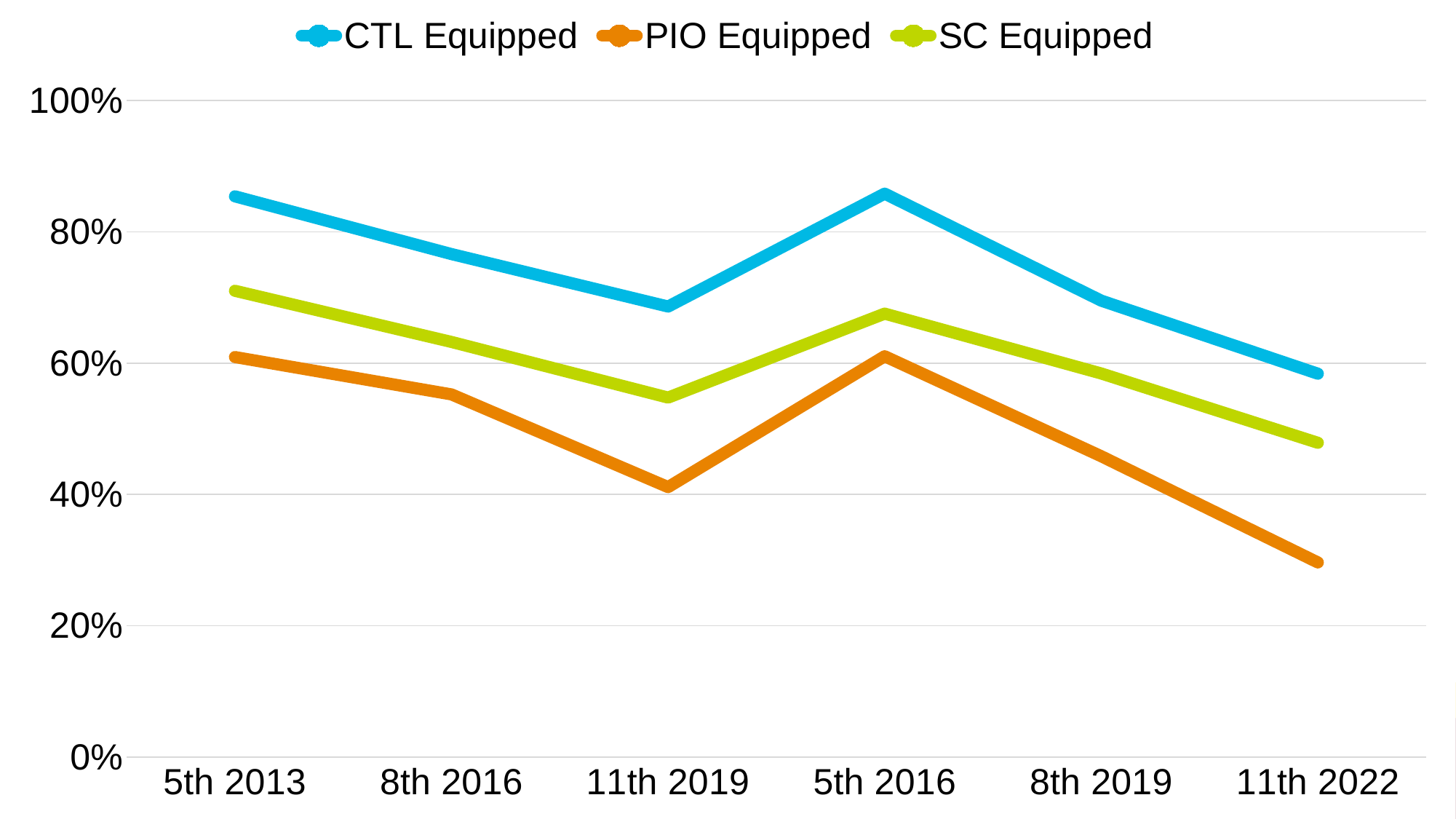
How many series does the legend list? 3 What kind of chart is shown on the slide? line chart Is the value for CTL Equipped at 11th 2019 greater or less than 80%? less Is the value for SC Equipped at 11th 2022 greater or less than 60%? less Which series has the highest value at 8th 2019? CTL Equipped Which is larger at 11th 2019, SC Equipped or PIO Equipped? SC Equipped At which category is PIO Equipped lowest? 11th 2022 Do the values for PIO Equipped rise or fall from 5th 2016 to 11th 2022? fall Is the value for CTL Equipped at 5th 2013 greater or less than 80%? greater At which category is CTL Equipped lowest? 11th 2022 How many categories are shown on the x axis? 6